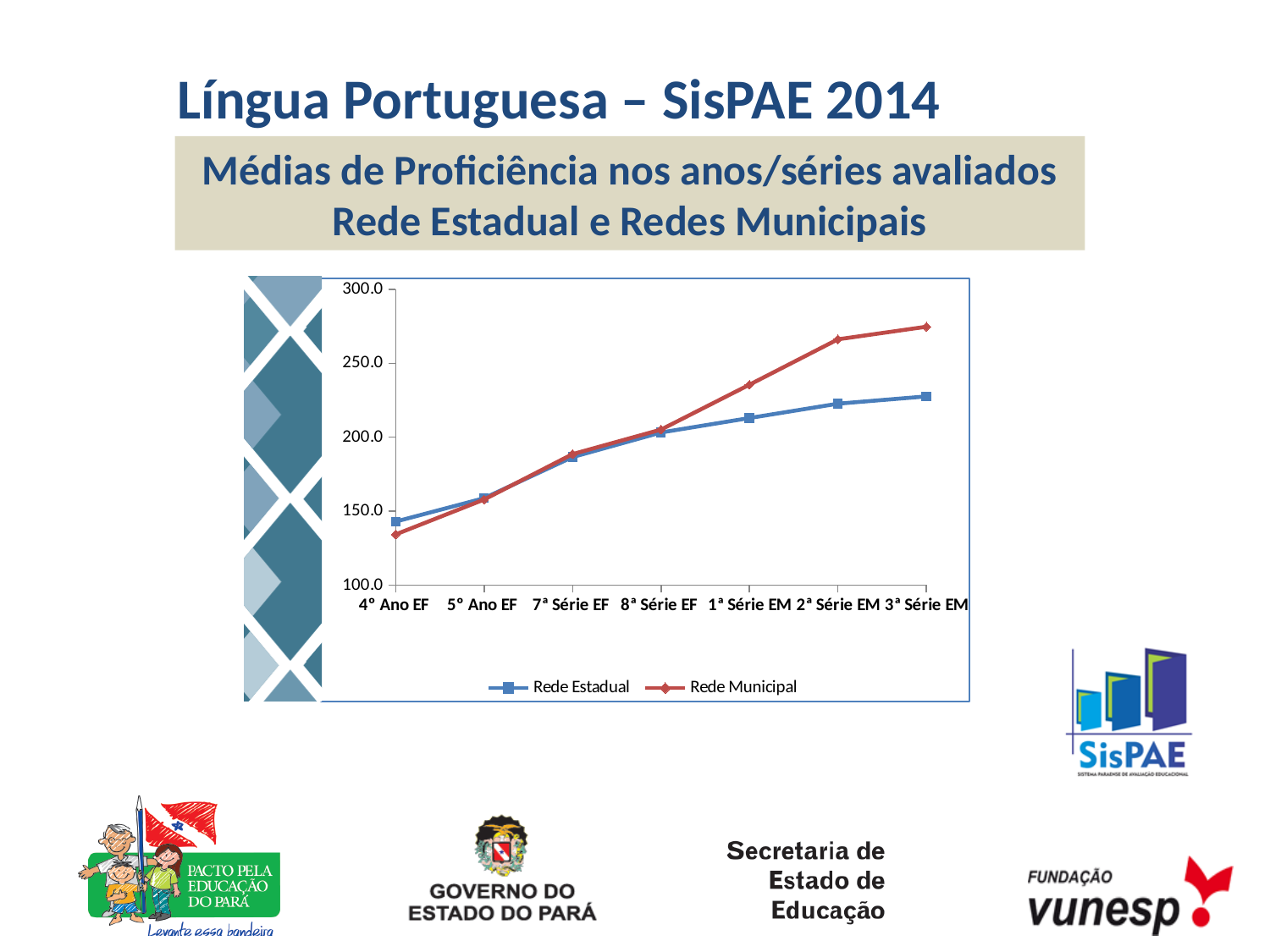
How many series does the legend list? 2 Which series is shown in red? Rede Municipal How many years/grades are plotted along the x axis? 7 Is the Rede Estadual value for 3ª Série EM greater or less than 250.0? less What kind of chart is shown on the slide? line chart For which year/grade is the Rede Municipal value highest? 3ª Série EM At 4° Ano EF, which series has the higher value, Rede Estadual or Rede Municipal? Rede Estadual Do the values for Rede Municipal rise or fall from 4° Ano EF to 3ª Série EM? rise Is the Rede Municipal value for 3ª Série EM greater or less than 250.0? greater At 3ª Série EM, which series has the higher value, Rede Estadual or Rede Municipal? Rede Municipal For which year/grade is the Rede Estadual value lowest? 4° Ano EF Is the Rede Municipal value for 4° Ano EF greater or less than 150.0? less